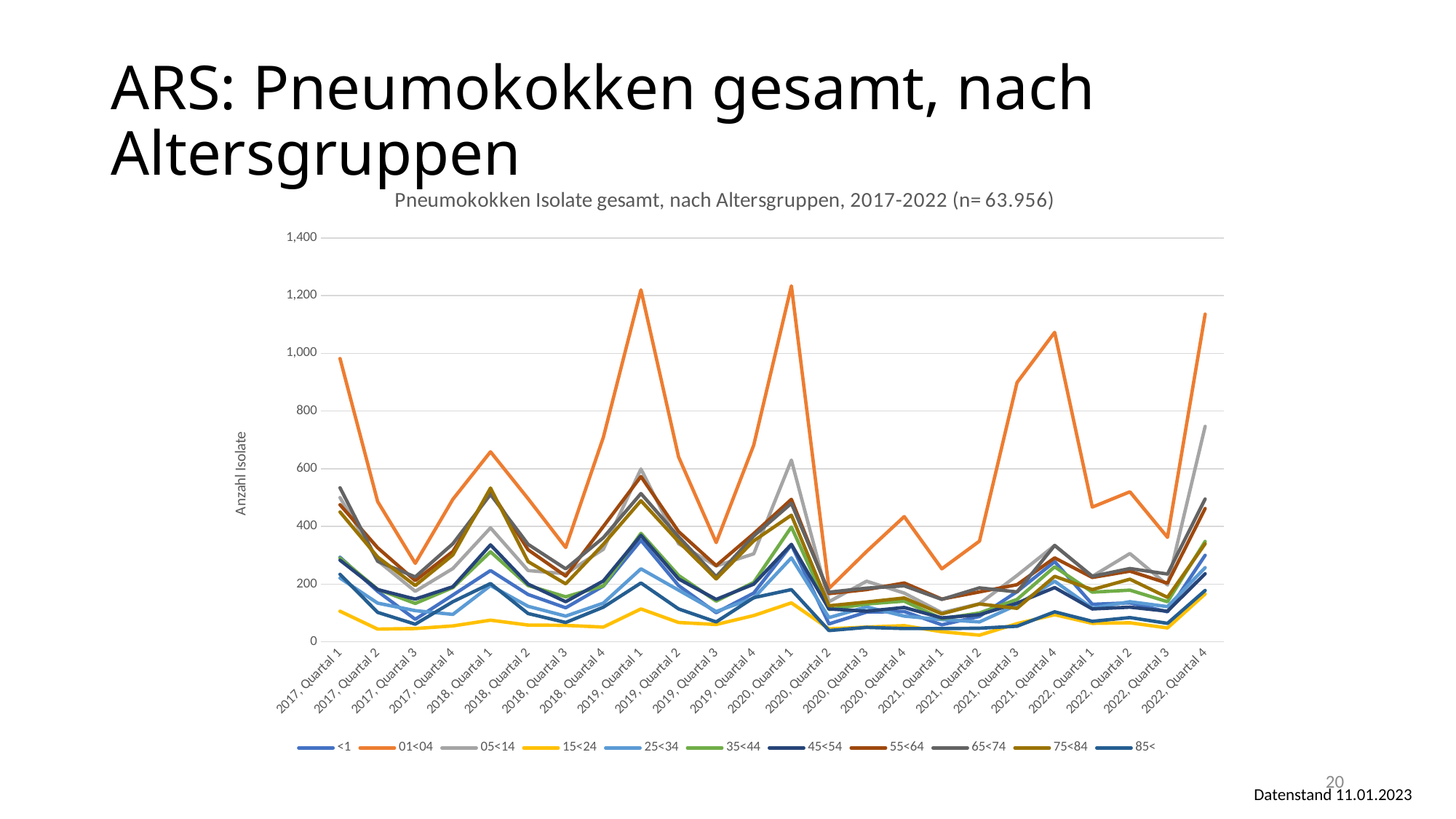
In 2019, Quartal 1, which is larger: the value for 01<04 or the value for 15<24? 01<04 Is the value for 15<24 in 2017, Quartal 1 greater or less than 200? less How many quarters are plotted along the x axis? 24 Is the value for 01<04 in 2020, Quartal 2 greater or less than 400? less Is the value for 05<14 in 2022, Quartal 4 greater or less than 600? greater How many series does the legend list? 11 Does the value for 01<04 rise or fall from 2020, Quartal 1 to 2020, Quartal 2? fall Which age group series reaches the highest value in the chart? 01<04 What kind of chart is shown on the slide? line chart What is the label of the y axis? Anzahl Isolate